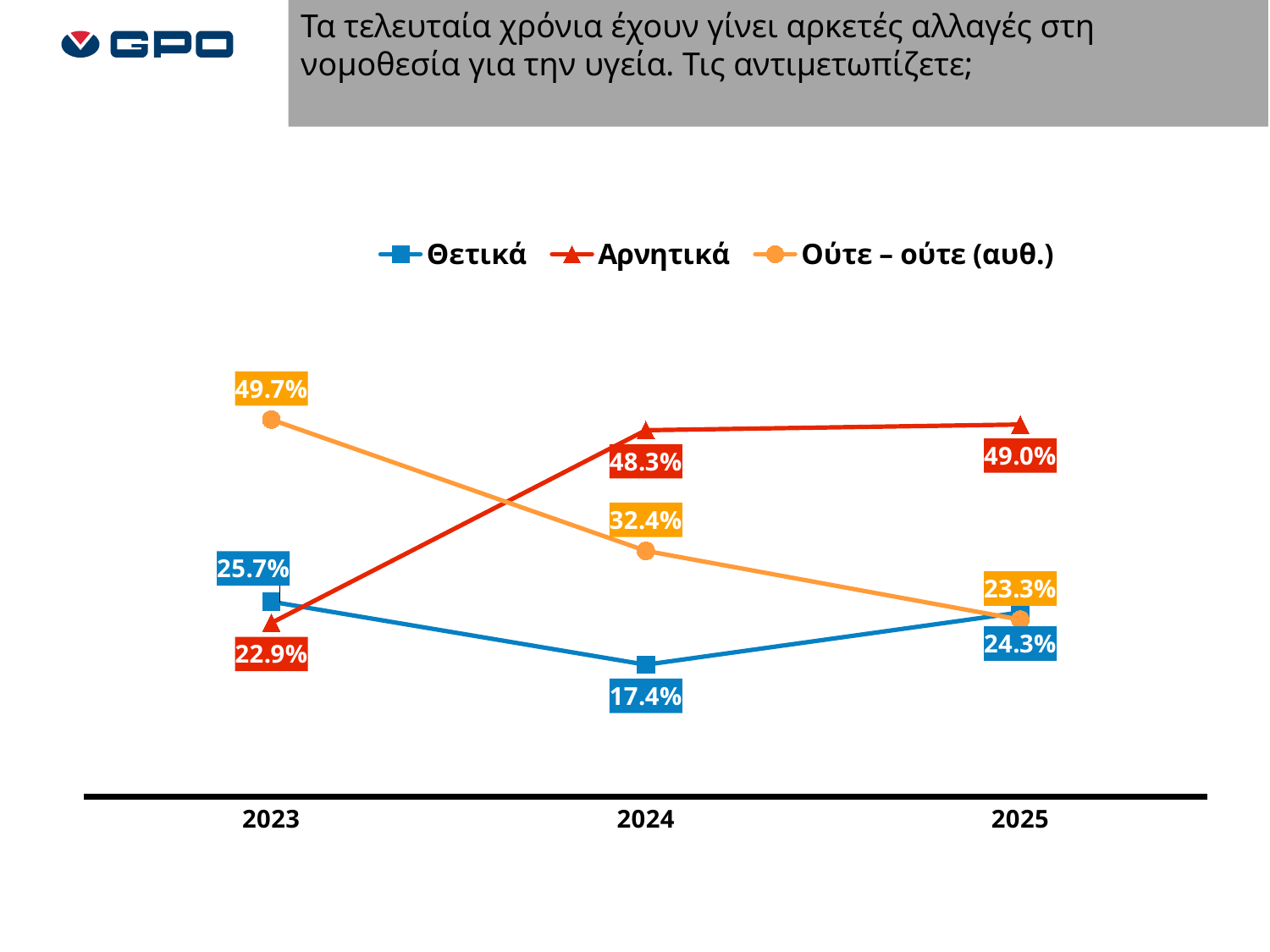
Which is larger in 2023, Θετικά or Αρνητικά? Θετικά What is the value for Αρνητικά in 2024? 48.3% What is the value for Θετικά in 2025? 24.3% Does the value for Ούτε – ούτε (αυθ.) rise or fall from 2023 to 2025? fall What kind of chart is shown on the slide? line chart What is the value for Ούτε – ούτε (αυθ.) in 2023? 49.7% What is the difference between Αρνητικά and Θετικά in 2024? 30.9% Which series is drawn with triangle markers? Αρνητικά In which year is the value for Θετικά lowest? 2024 In which year is the value for Ούτε – ούτε (αυθ.) highest? 2023 How many years are shown on the x axis? 3 How many series does the legend list? 3